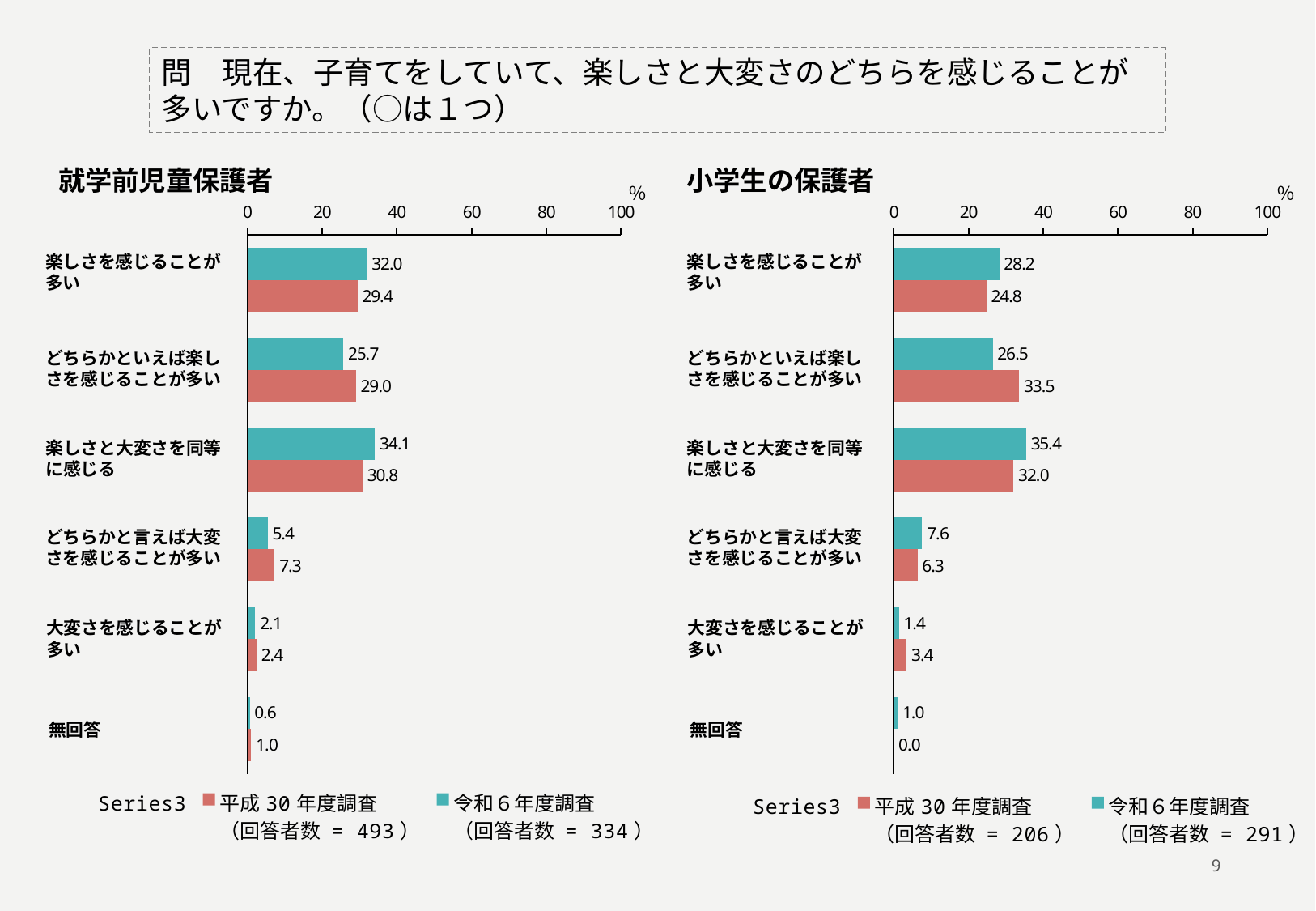
In the 就学前児童保護者 chart, which is larger for どちらかと言えば大変さを感じることが多い: the 平成30年度調査 value or the 令和６年度調査 value? 平成30年度調査 What is the number of respondents (回答者数) for the 令和６年度調査 in the 就学前児童保護者 chart? 334 In the 小学生の保護者 chart, is the 令和６年度調査 value for 楽しさと大変さを同等に感じる greater or less than 20? greater In the 就学前児童保護者 chart, what is the difference between the 令和６年度調査 and 平成30年度調査 values for 楽しさと大変さを同等に感じる? 3.3 In the 小学生の保護者 chart, what is the 平成30年度調査 value for 無回答? 0.0 How many categories are shown in the 就学前児童保護者 chart? 6 In the 就学前児童保護者 chart, which category has the highest 令和６年度調査 value? 楽しさと大変さを同等に感じる What type of chart is the 小学生の保護者 chart? bar chart In the 小学生の保護者 chart, what is the 平成30年度調査 value for どちらかといえば楽しさを感じることが多い? 33.5 In the 小学生の保護者 chart, what is the difference between the 平成30年度調査 and 令和６年度調査 values for どちらかといえば楽しさを感じることが多い? 7.0 In the 就学前児童保護者 chart, what is the 令和６年度調査 value for 楽しさを感じることが多い? 32.0 In the 小学生の保護者 chart, which category has the lowest 平成30年度調査 value? 無回答